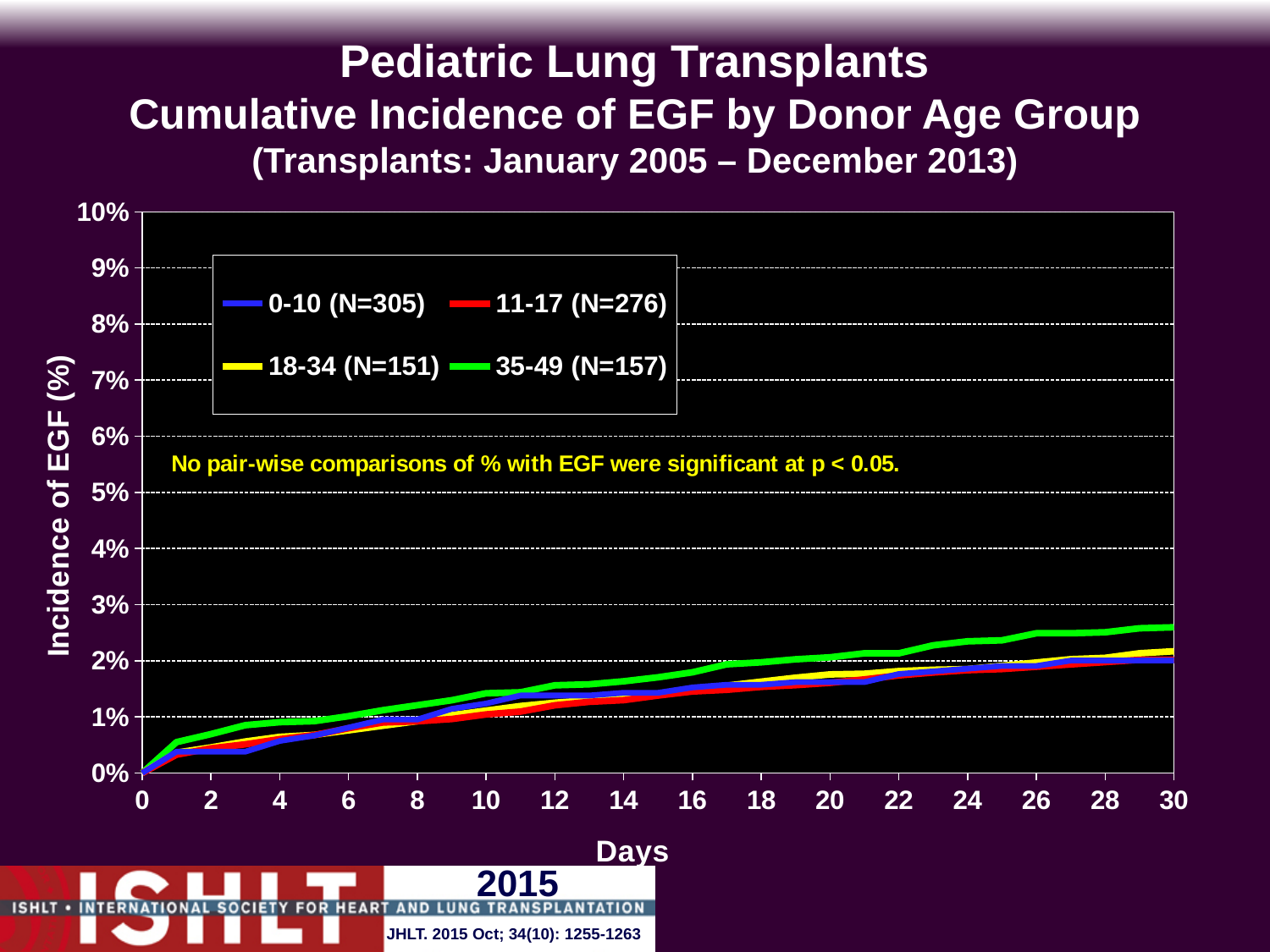
Do the cumulative incidence lines rise or fall as the number of days increases? rise How many series does the legend list? 4 Is the value for the 35-49 (N=157) group at day 30 greater or less than 2%? greater How many transplants (N) are in the 0-10 donor age group according to the legend? 305 Is the value for the 0-10 (N=305) group at day 10 greater or less than 1%? greater Is the value for the 35-49 (N=157) group at day 30 greater or less than 3%? less What is the cumulative incidence of EGF for all groups at day 0? 0% At day 30, which is larger: the value for the 35-49 (N=157) group or the 18-34 (N=151) group? 35-49 (N=157) What kind of chart is shown on the slide? line chart What is the label of the y-axis? Incidence of EGF (%) Which donor age group has the highest cumulative incidence of EGF at day 30? 35-49 (N=157)